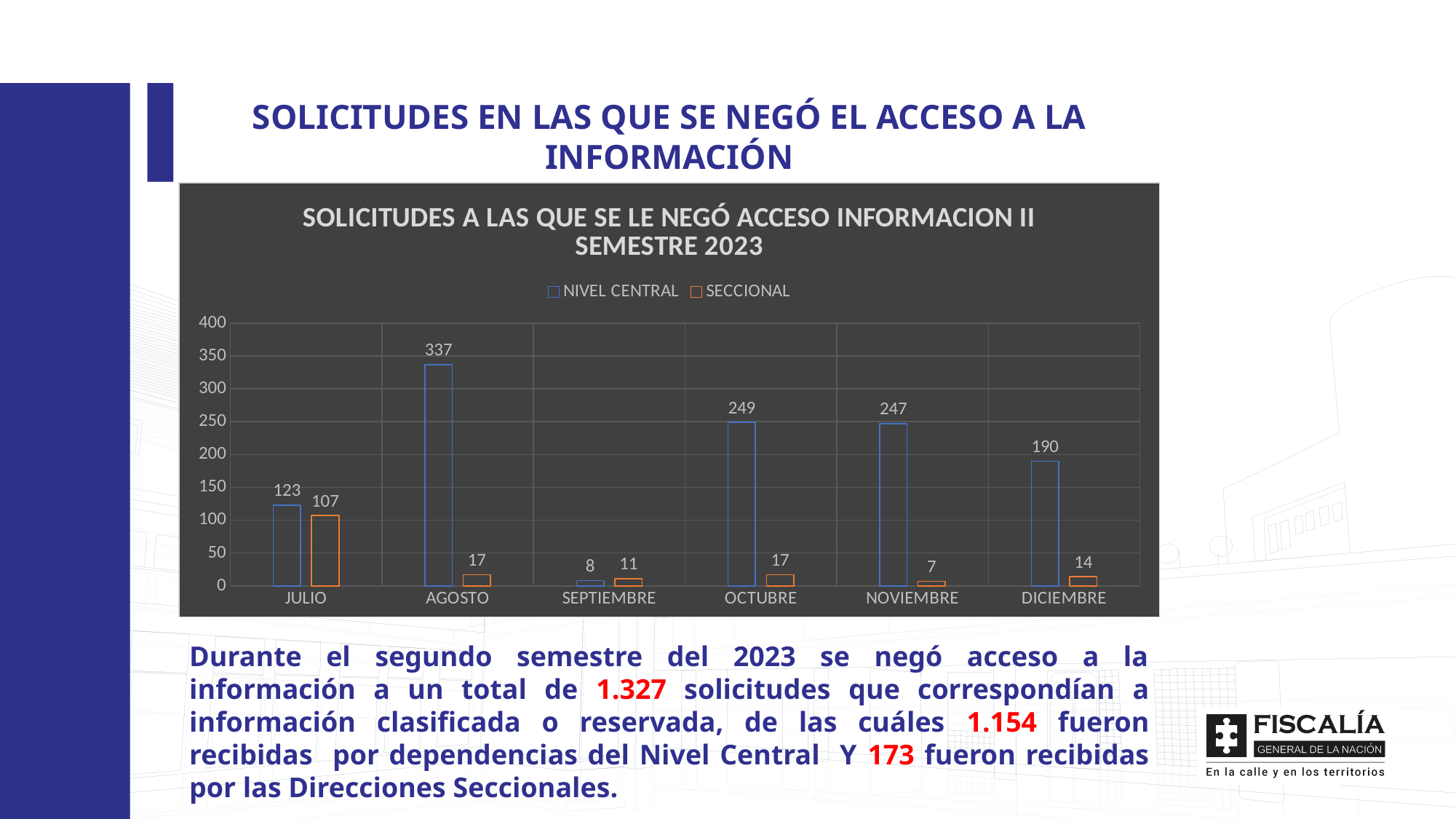
What is the SECCIONAL value for JULIO? 107 What is the NIVEL CENTRAL value for DICIEMBRE? 190 Which is larger in SEPTIEMBRE, the NIVEL CENTRAL value or the SECCIONAL value? SECCIONAL Which series is shown in orange? SECCIONAL How many series does the legend list? 2 Which month has the lowest SECCIONAL value? NOVIEMBRE Which month has the highest NIVEL CENTRAL value? AGOSTO What kind of chart is shown? Bar chart What is the NIVEL CENTRAL value for AGOSTO? 337 What is the difference between the NIVEL CENTRAL and SECCIONAL values for OCTUBRE? 232 What is the title of the chart? SOLICITUDES A LAS QUE SE LE NEGÓ ACCESO INFORMACION II SEMESTRE 2023 How many months are shown on the x axis? 6